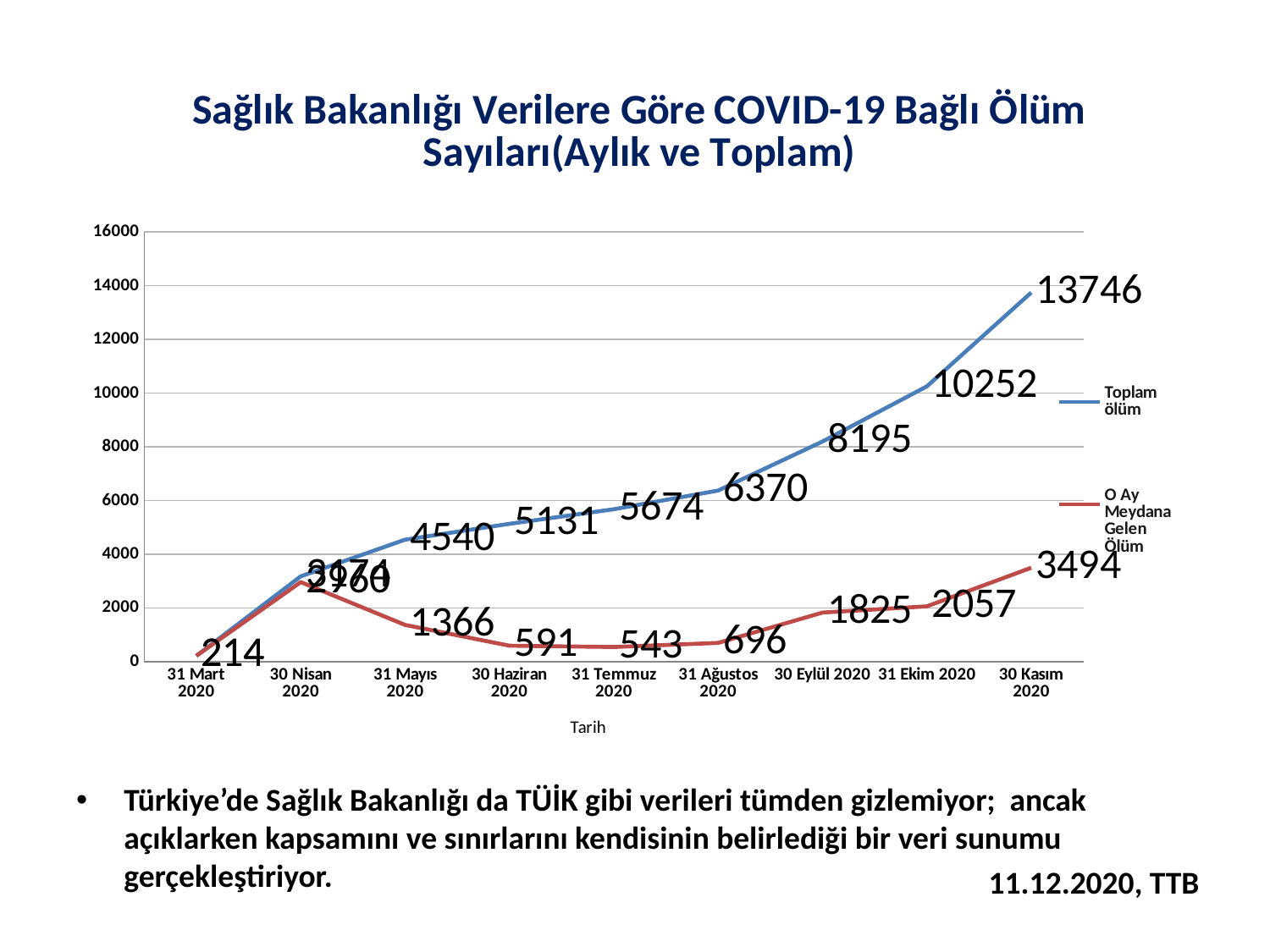
By how much did Toplam ölüm increase from 31 Ekim 2020 to 30 Kasım 2020? 3494 What is the difference between O Ay Meydana Gelen Ölüm at 31 Ekim 2020 and at 30 Eylül 2020? 232 What is the value of Toplam ölüm at 30 Kasım 2020? 13746 At which date is O Ay Meydana Gelen Ölüm highest? 30 Kasım 2020 Which is larger for O Ay Meydana Gelen Ölüm: the value at 31 Ağustos 2020 or at 30 Haziran 2020? 31 Ağustos 2020 Does Toplam ölüm rise or fall from 31 Mart 2020 to 30 Kasım 2020? rise What is the value of Toplam ölüm at 30 Eylül 2020? 8195 What is the value of O Ay Meydana Gelen Ölüm at 31 Temmuz 2020? 543 How many dates are plotted along the x axis? 9 How many series does the legend list? 2 At which date is O Ay Meydana Gelen Ölüm lowest? 31 Mart 2020 What type of chart is shown on the slide? line chart